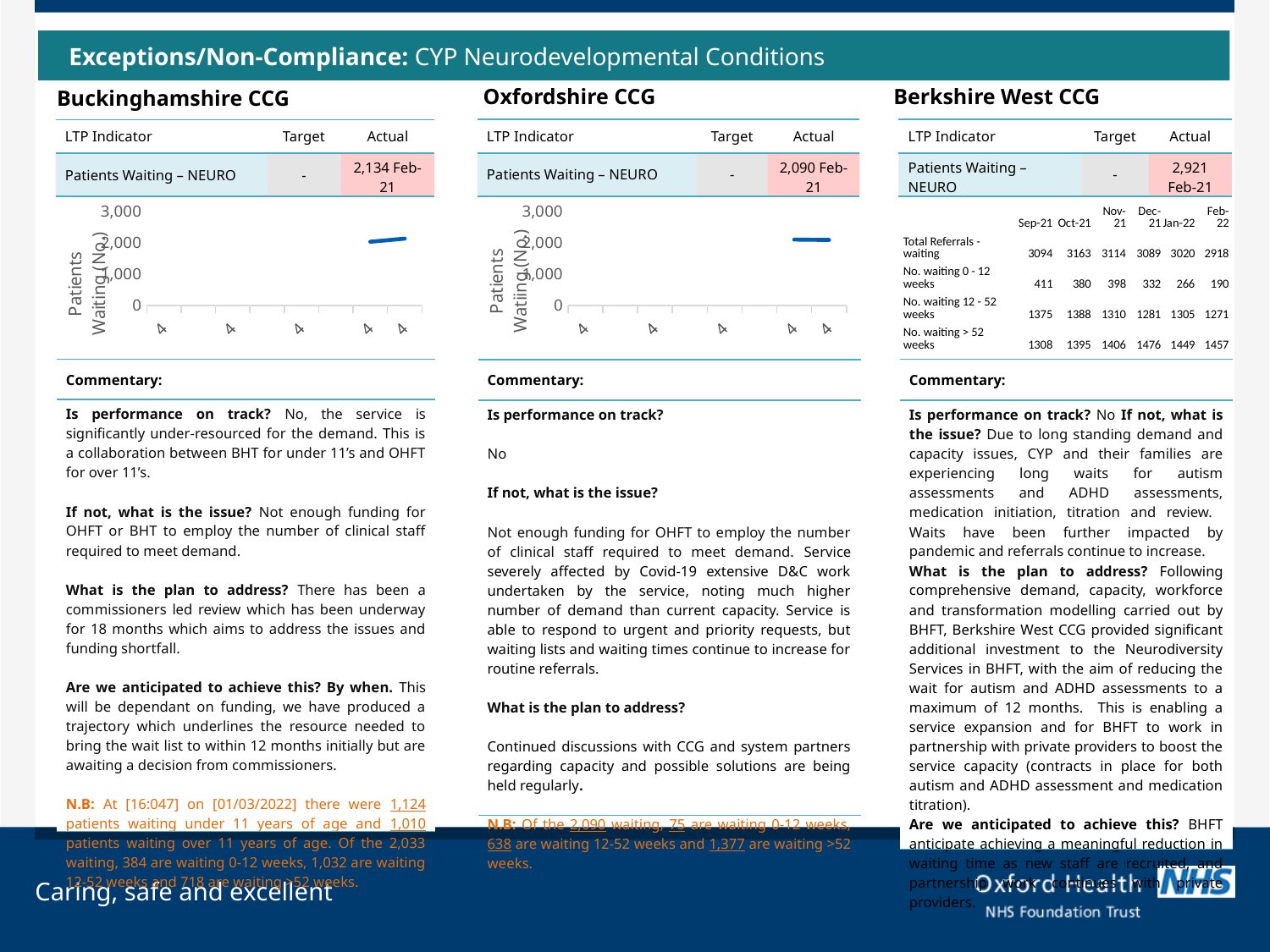
In the Oxfordshire CCG chart, are the plotted values greater or less than 3,000? less How many line charts are shown on the slide? 2 What kind of chart is shown under Oxfordshire CCG? line chart In the Oxfordshire CCG chart, are the plotted values greater or less than 1,000? greater In the Buckinghamshire CCG chart, are the plotted values greater or less than 3,000? less What kind of chart is shown under Buckinghamshire CCG? line chart What is the y-axis title of the Buckinghamshire CCG chart? Patients Waiting (No.)